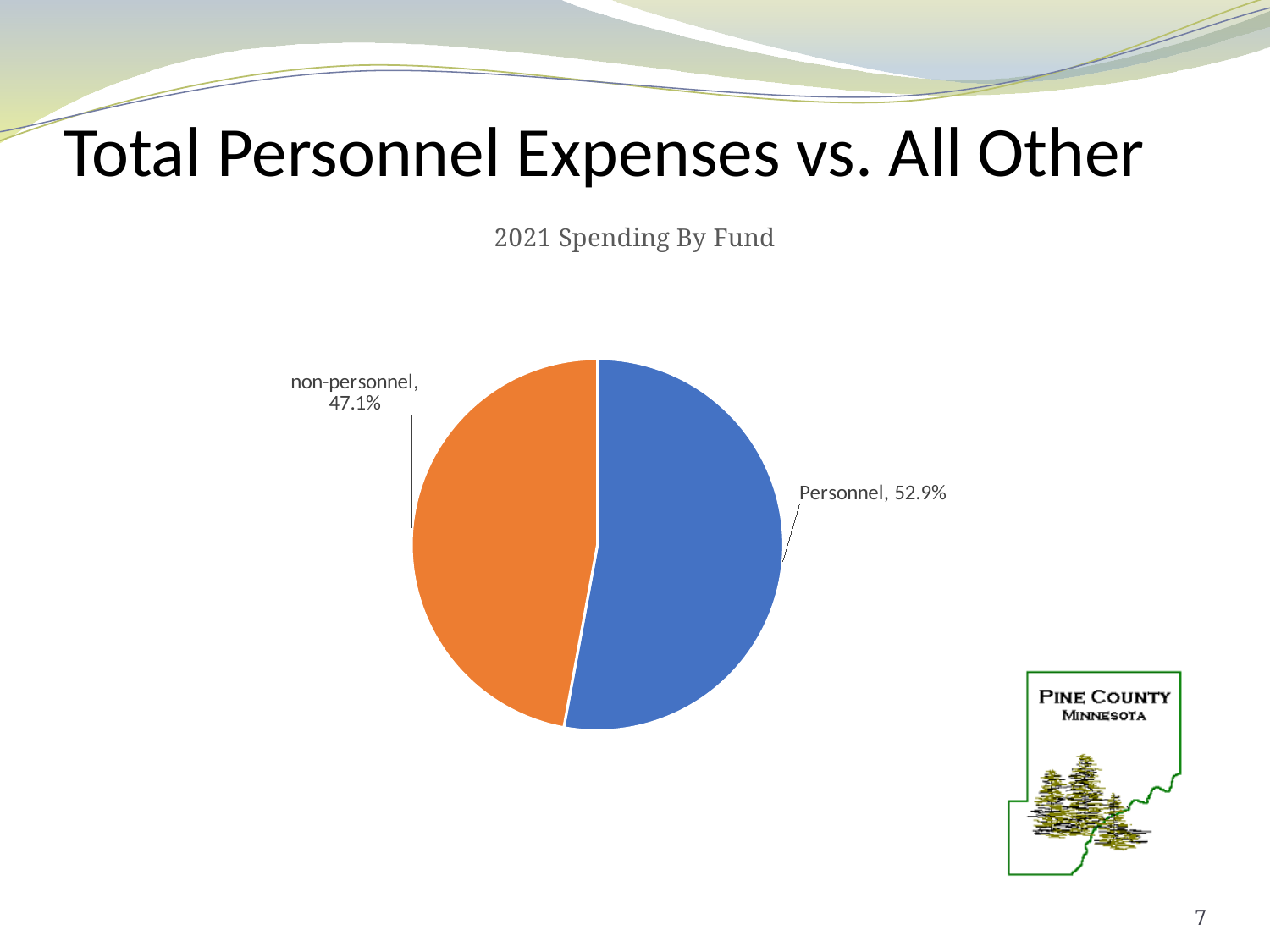
What share of 2021 spending does the non-personnel slice represent? 47.1% What is the title of the chart? 2021 Spending By Fund Is the non-personnel share greater or less than 50%? less What colour is the Personnel slice? blue How many slices does the pie chart have? 2 Which slice of the pie is the largest? Personnel Which is larger, the Personnel slice or the non-personnel slice? Personnel Is the Personnel share greater or less than 50%? greater Which slice of the pie is the smallest? non-personnel What kind of chart is shown on the slide? pie chart What is the difference in percentage points between the Personnel and non-personnel slices? 5.8 What share of 2021 spending does the Personnel slice represent? 52.9%